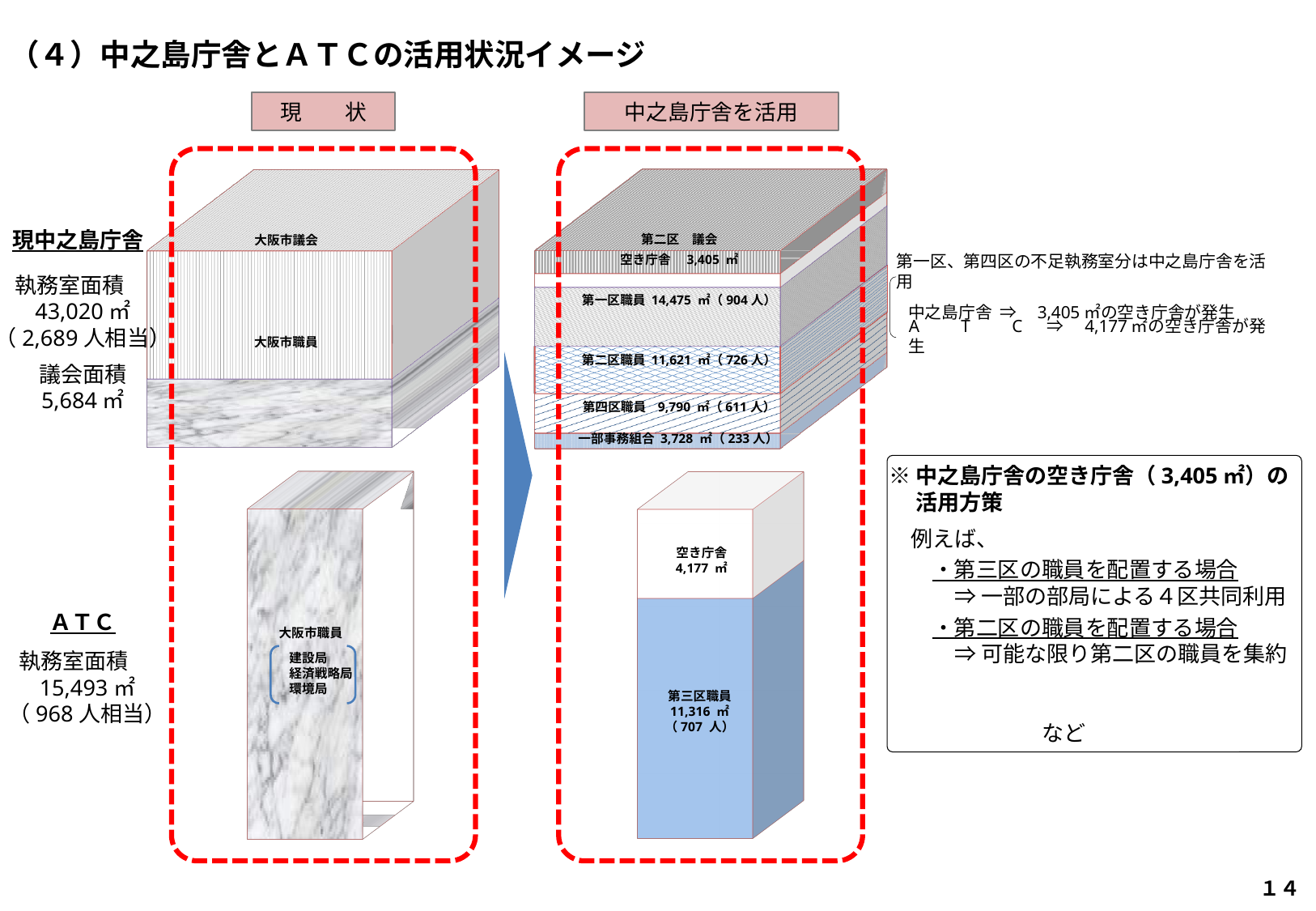
In the right-hand '中之島庁舎を活用' diagram, what floor area is labelled for 第一区職員? 14,475 ㎡ In the right-hand '中之島庁舎を活用' Nakanoshima block, how many labelled segments are shown below the 第二区 議会 segment? 5 In the right-hand '中之島庁舎を活用' Nakanoshima block, what is the difference in area between 第一区職員 and 第二区職員? 2,854 ㎡ In the left-hand '現状' diagram, what is the 執務室面積 of the current Nakanoshima building (現中之島庁舎)? 43,020 ㎡ In the right-hand ATC block diagram, what is the total of the 空き庁舎 and 第三区職員 areas? 15,493 ㎡ In the right-hand '中之島庁舎を活用' Nakanoshima block, which staff group occupies the largest labelled area? 第一区職員 In the right-hand '中之島庁舎を活用' Nakanoshima block, which has the larger area, 第四区職員 or 一部事務組合? 第四区職員 In the right-hand '中之島庁舎を活用' diagram, how many people are shown for 第二区職員? 726 人 In the right-hand ATC block diagram, what area is labelled for 第三区職員? 11,316 ㎡ In the right-hand '中之島庁舎を活用' diagram, what area is labelled as 空き庁舎 in the Nakanoshima building? 3,405 ㎡ In the left-hand '現状' diagram, what is the 執務室面積 of ATC? 15,493 ㎡ In the right-hand '中之島庁舎を活用' Nakanoshima block, which labelled segment has the smallest area? 空き庁舎